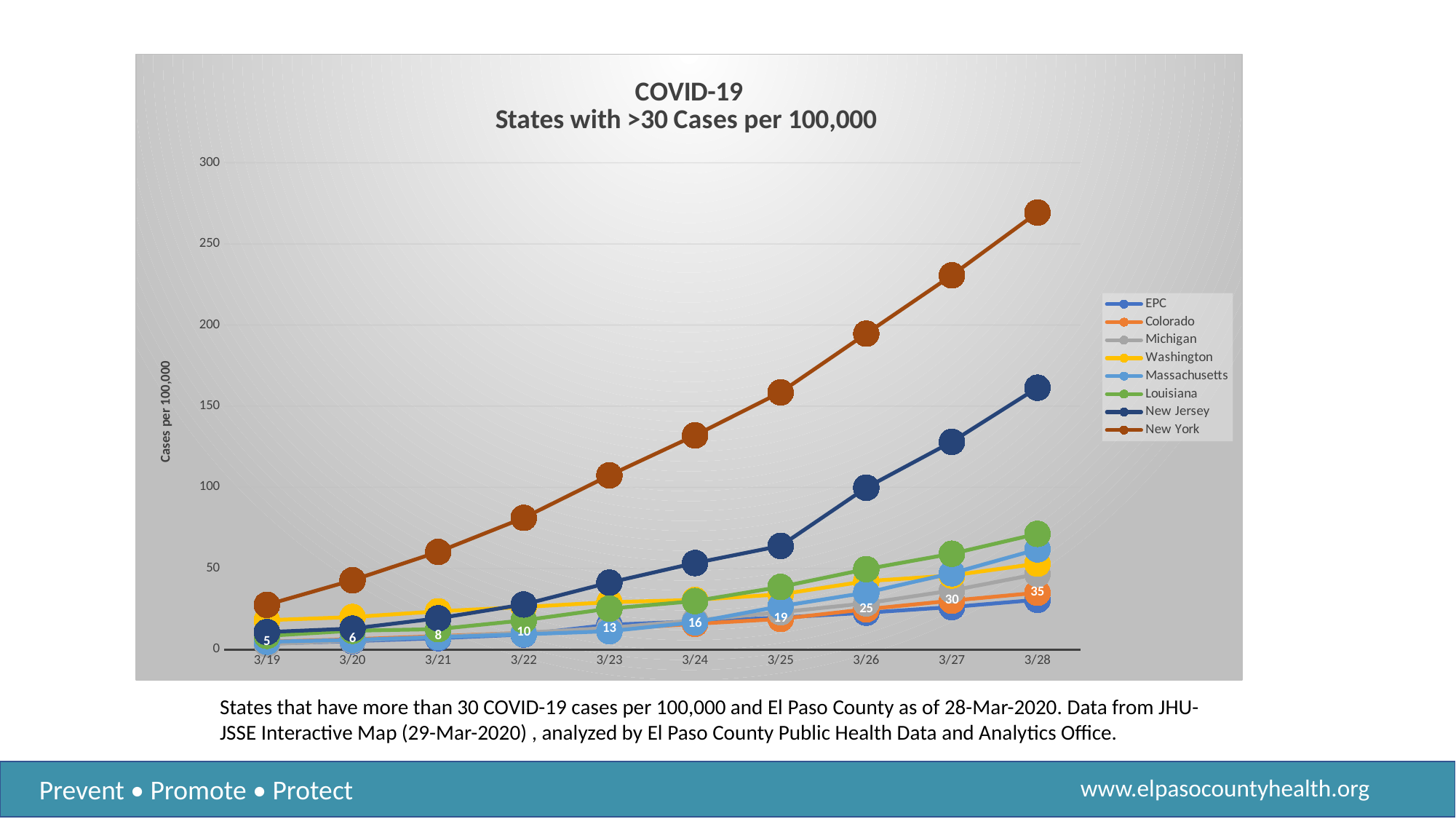
How many series does the legend list? 8 Which is larger on 3/26, New York or New Jersey? New York Which series has the highest value on 3/28? New York Is the value for New York on 3/19 greater or less than 50? less Do the EPC values rise or fall from 3/19 to 3/28? rise What kind of chart is shown on the slide? line chart How many dates are plotted along the x axis? 10 Is the value for New York on 3/28 greater or less than 250? greater